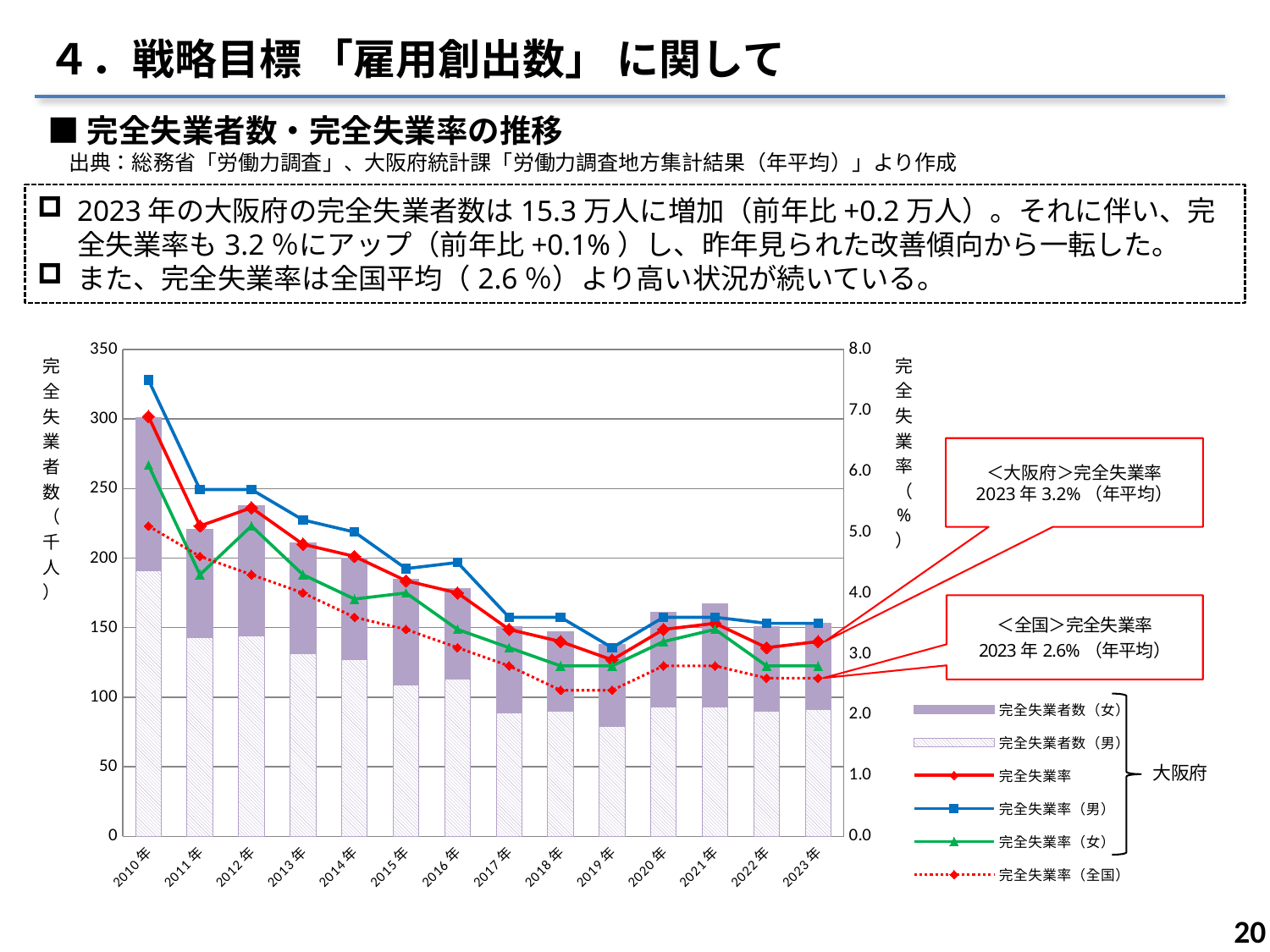
Is the total stacked bar for unemployed persons in 2019 greater or less than 150? less What kind of chart is shown on the slide? A combined stacked bar and line chart Which legend series is drawn as a dotted line? 完全失業率（全国） How many years are shown on the x axis of the chart? 14 What is the national (全国) unemployment rate for 2023 shown in the callout on the chart? 2.6% In 2023, which is higher: the Osaka Prefecture unemployment rate or the national unemployment rate? Osaka Prefecture (大阪府) Is the male unemployment rate (完全失業率（男）) for 2010 greater or less than 7.0? greater In which year is the stacked bar for total unemployed persons (完全失業者数) the shortest? 2019年 In which year is the stacked bar for total unemployed persons (完全失業者数) the tallest? 2010年 How many series does the chart legend list? 6 What is the Osaka Prefecture unemployment rate (完全失業率) for 2023 shown in the callout on the chart? 3.2% By how many percentage points does the 2023 Osaka Prefecture unemployment rate (3.2%) exceed the 2023 national rate (2.6%)? 0.6 percentage points